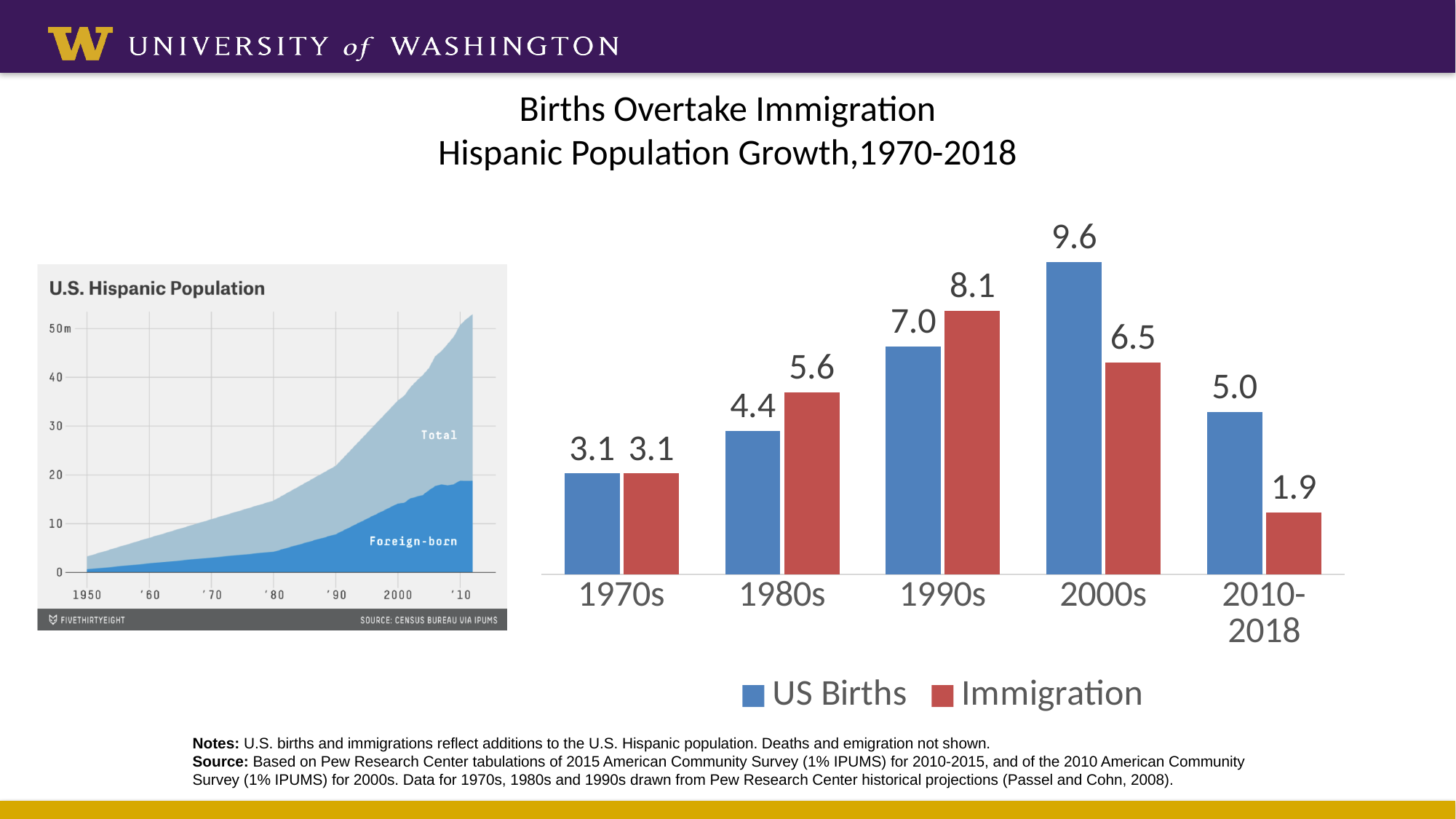
In the bar chart on the right, how many periods are shown on the x axis? 5 In the bar chart on the right, what is the difference between US Births and Immigration in the 2000s? 3.1 What kind of chart is the chart on the right of the slide? bar chart In the bar chart on the right, which is larger in the 1980s, US Births or Immigration? Immigration In the bar chart on the right, which decade has the highest Immigration value? 1990s In the bar chart on the right, how many series does the legend list? 2 In the left chart titled 'U.S. Hispanic Population', is the Total value in 2000 greater or less than 30m? greater In the bar chart on the right, which period has the lowest US Births value? 1970s In the bar chart on the right, do the Immigration values rise or fall from the 1990s to 2010-2018? fall In the bar chart on the right, what is the US Births value for the 2000s? 9.6 In the bar chart on the right, what is the Immigration value for 2010-2018? 1.9 In the left chart titled 'U.S. Hispanic Population', which two series are labelled in the plot area? Total and Foreign-born